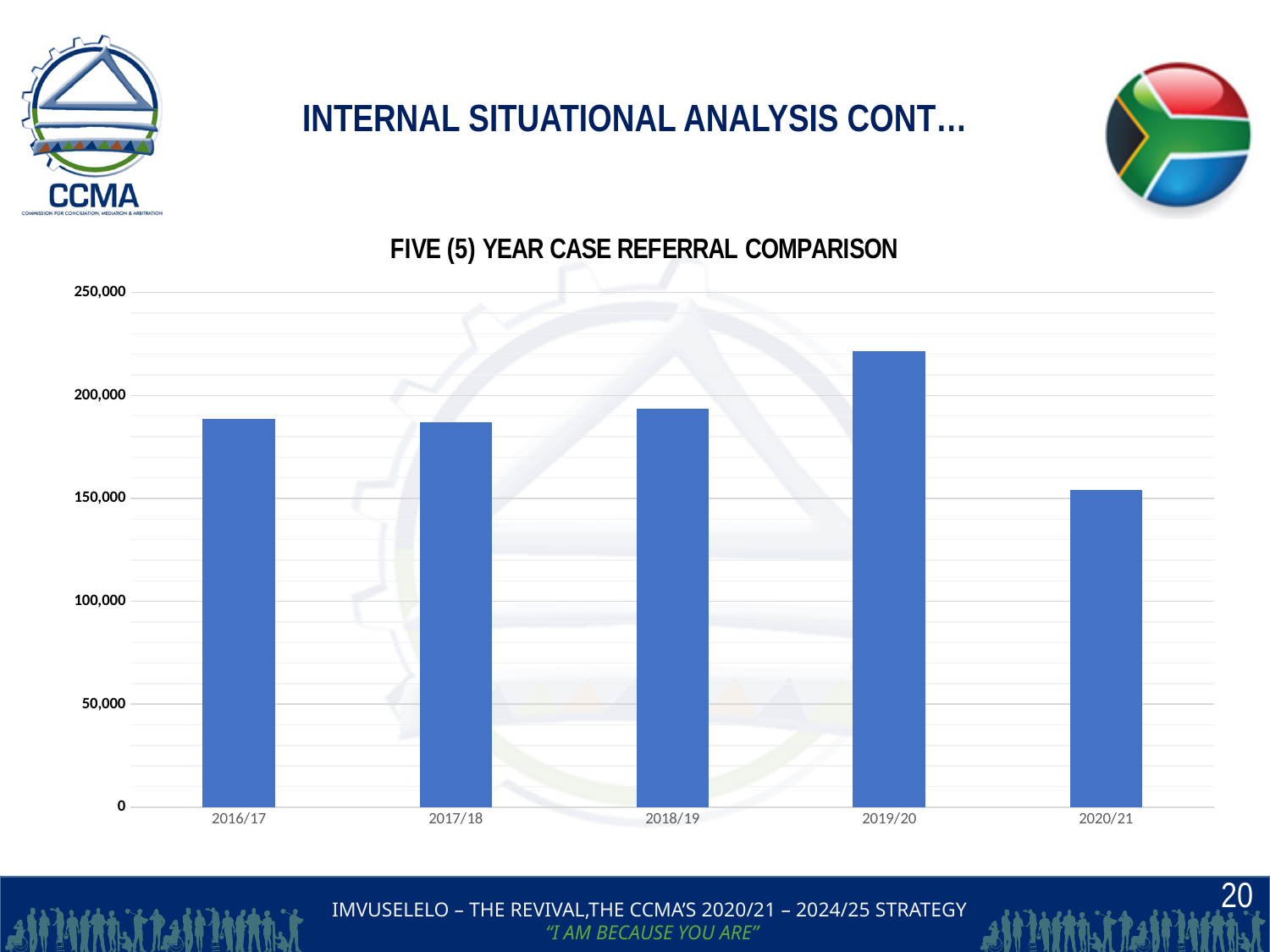
What colour are the bars in the chart? blue Is the value for 2020/21 greater or less than 200,000? less Is the value for 2019/20 greater or less than 200,000? greater Which is larger, the value for 2019/20 or the value for 2020/21? 2019/20 What kind of chart is shown on the slide? bar chart Is the value for 2017/18 greater or less than 150,000? greater How many years (categories) are shown on the x axis of the chart? 5 Which year has the lowest number of case referrals? 2020/21 Does the value rise or fall from 2019/20 to 2020/21? fall What is the title of the chart? FIVE (5) YEAR CASE REFERRAL COMPARISON Which year has the highest number of case referrals? 2019/20